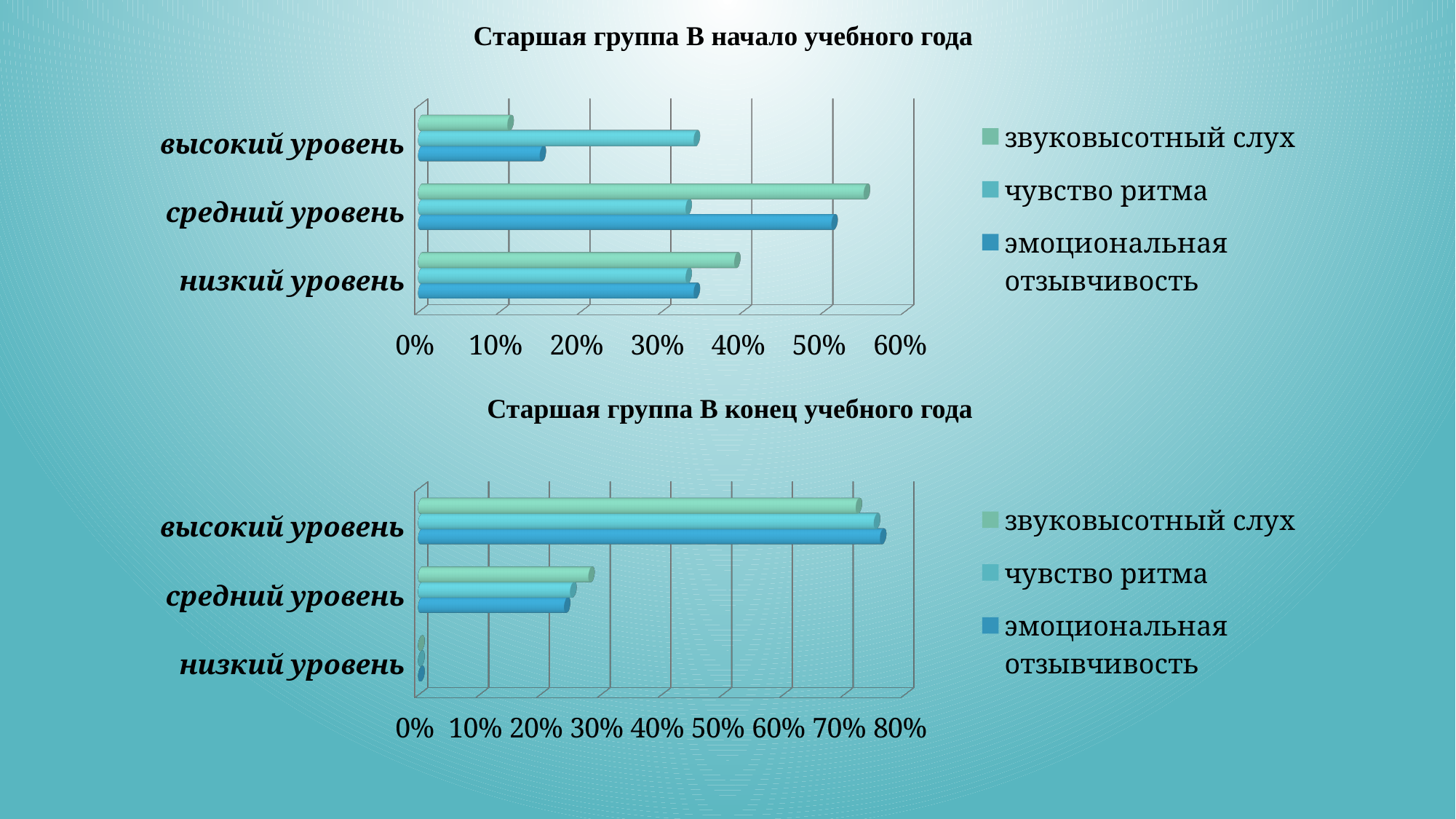
In the bottom chart, 'Старшая группа В конец учебного года', which category has the lowest value for эмоциональная отзывчивость? низкий уровень In the bottom chart, 'Старшая группа В конец учебного года', is the value of звуковысотный слух for высокий уровень greater or less than 60%? greater How many series does the legend of the bottom chart, 'Старшая группа В конец учебного года', list? 3 In the top chart, 'Старшая группа В начало учебного года', is the value of эмоциональная отзывчивость for средний уровень greater or less than 40%? greater In the top chart, 'Старшая группа В начало учебного года', for высокий уровень, which is larger: чувство ритма or эмоциональная отзывчивость? чувство ритма In the top chart, 'Старшая группа В начало учебного года', is the value of звуковысотный слух for высокий уровень greater or less than 20%? less In the top chart, 'Старшая группа В начало учебного года', which category has the highest value for звуковысотный слух? средний уровень How many categories are shown on the y axis of the top chart, 'Старшая группа В начало учебного года'? 3 What kind of chart is the top chart, 'Старшая группа В начало учебного года'? bar chart In the bottom chart, 'Старшая группа В конец учебного года', which category has the highest value for чувство ритма? высокий уровень What is the title of the top chart on the slide? Старшая группа В начало учебного года